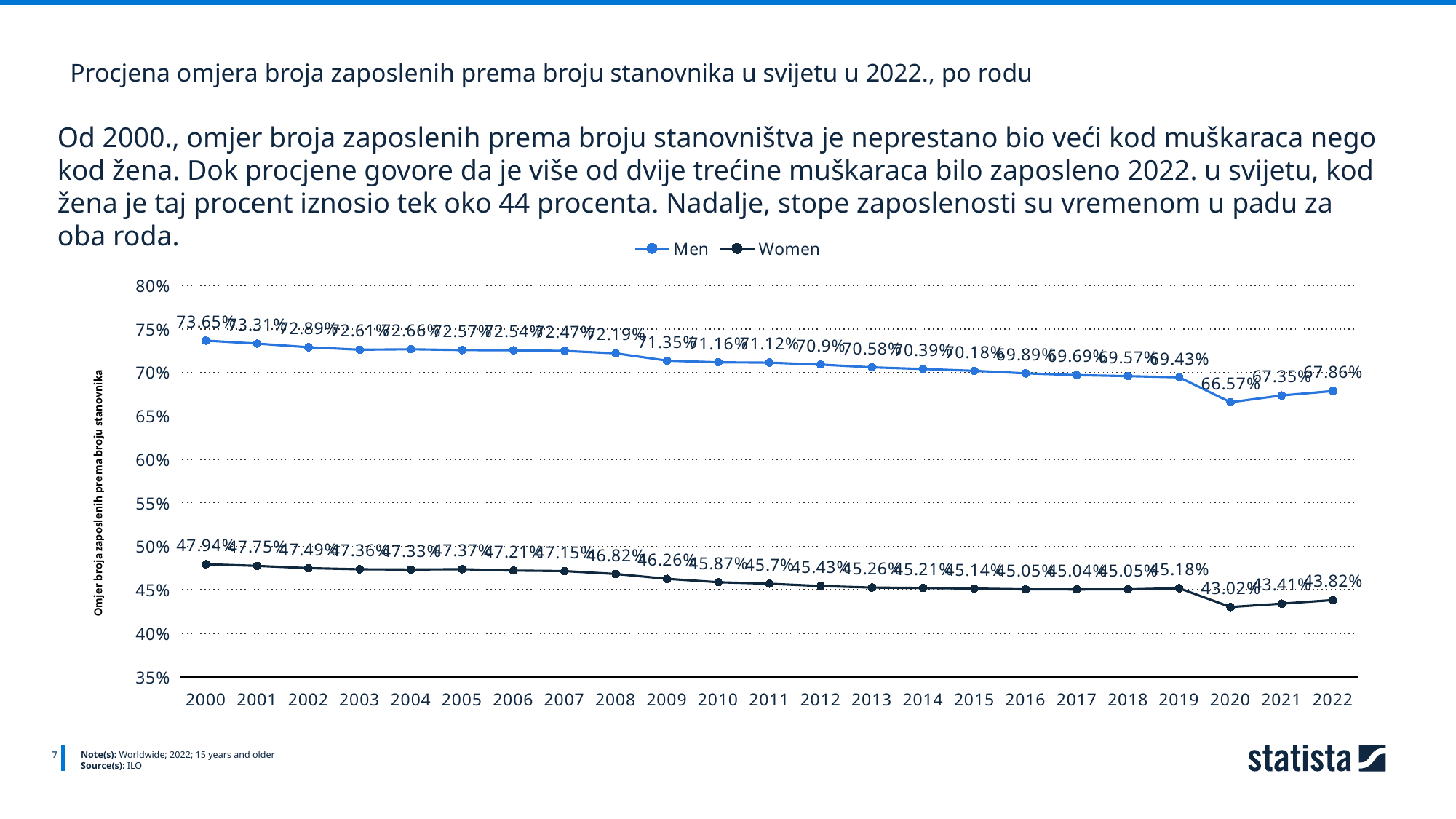
How many series does the legend list? 2 In which year is the Women series at its highest? 2000 What is the value for Men in 2000? 73.65% What is the value for Women in 2020? 43.02% What is the value for Women in 2022? 43.82% How many years are shown on the x axis? 23 What kind of chart is shown on the slide? line chart Is the value for Men in 2010 greater or less than 70%? greater In which year is the Men series at its lowest? 2020 What is the difference between the Men and Women values in 2022? 24.04 percentage points Which year has the higher value for Men, 2021 or 2022? 2022 What is the value for Men in 2020? 66.57%